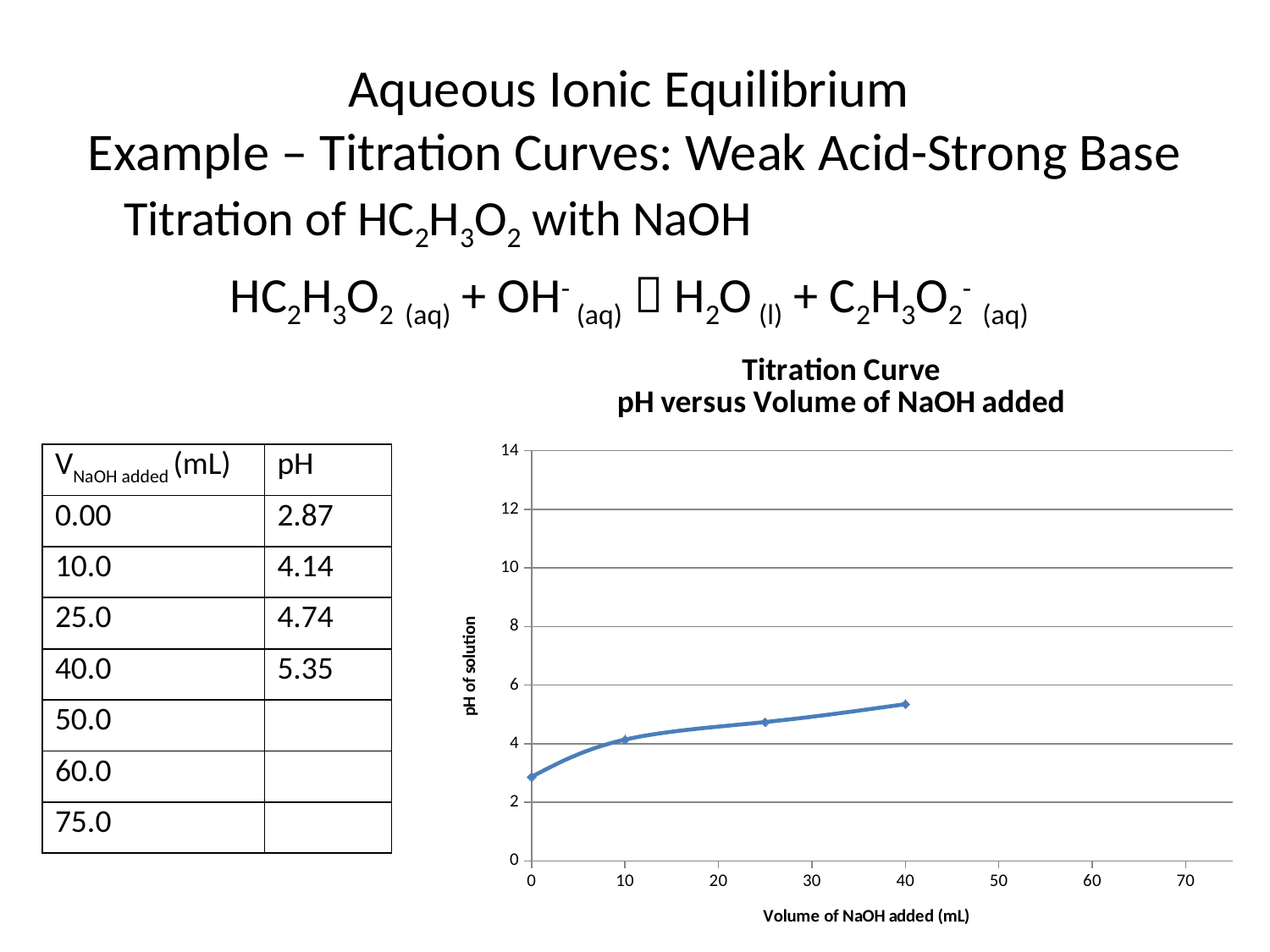
Is the pH at 40 mL of NaOH added greater or less than 6? less How many data points are plotted on the chart? 4 What kind of chart is shown on the slide? line chart What is the difference in pH between 40.0 mL and 0.00 mL of NaOH added? 2.48 What is the label of the x axis of the chart? Volume of NaOH added (mL) According to the slide, what is the pH when 0.00 mL of NaOH has been added? 2.87 At which volume of NaOH added is the plotted pH highest? 40.0 mL According to the slide, what is the pH when 40.0 mL of NaOH has been added? 5.35 What is the title of the chart? Titration Curve pH versus Volume of NaOH added Does the pH rise or fall as the volume of NaOH added increases along the x axis? rise According to the slide, what is the pH when 25.0 mL of NaOH has been added? 4.74 At which volume of NaOH added is the plotted pH lowest? 0.00 mL